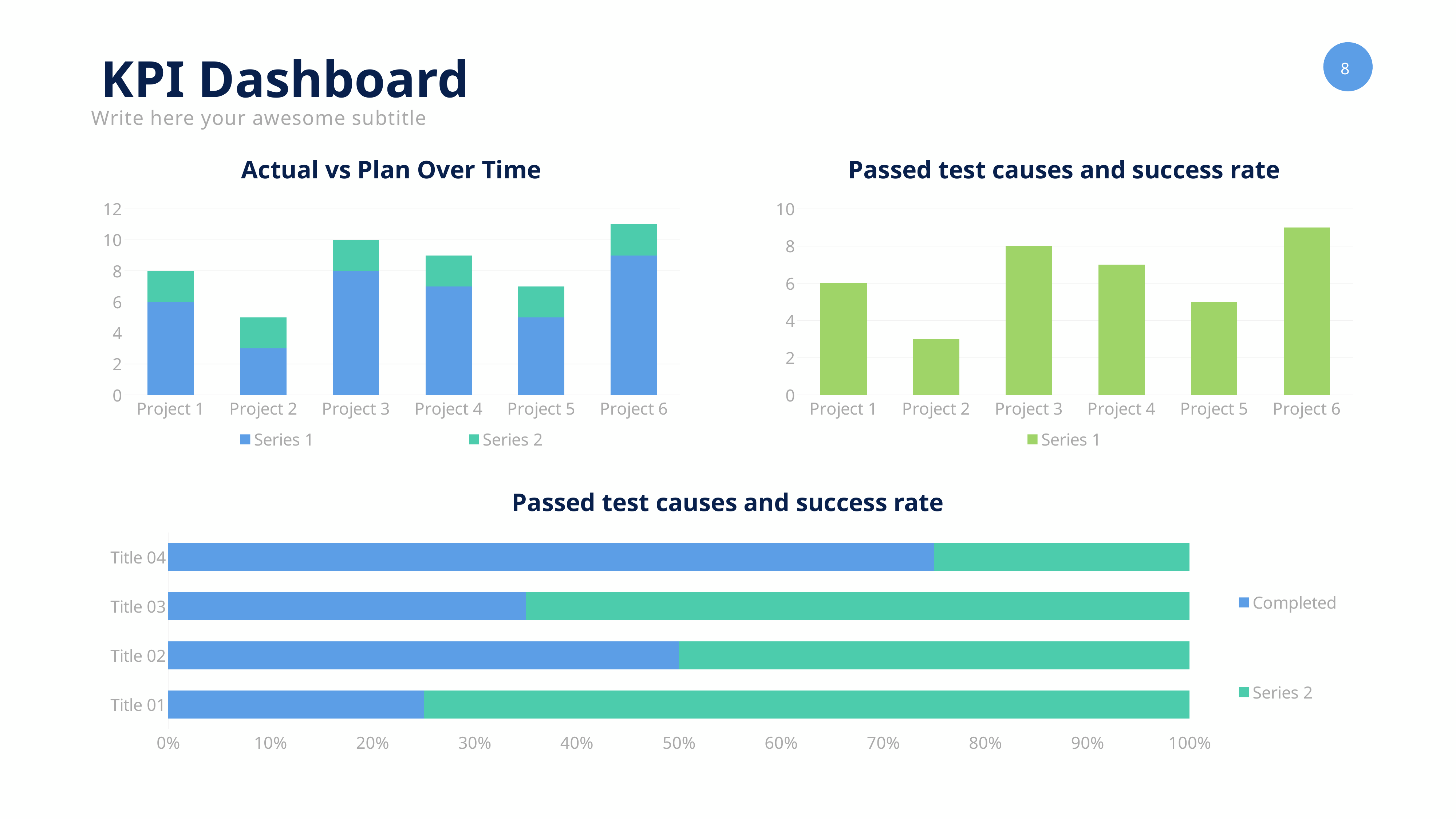
In the bottom 'Passed test causes and success rate' chart, what is the Completed value for Title 02? 50% In the top-right 'Passed test causes and success rate' chart, which project has the highest value? Project 6 In the 'Actual vs Plan Over Time' chart, what is the Series 1 value for Project 1? 6 In the 'Actual vs Plan Over Time' chart, what is the total height of the stacked bar for Project 3? 10 In the top-right 'Passed test causes and success rate' chart, what is the value for Project 1? 6 In the 'Actual vs Plan Over Time' chart, what is the Series 1 value for Project 3? 8 In the 'Actual vs Plan Over Time' chart, is the Series 1 value for Project 2 greater or less than 4? less In the top-right 'Passed test causes and success rate' chart, how many projects are shown on the x axis? 6 In the top-right 'Passed test causes and success rate' chart, which project has the lowest value? Project 2 In the 'Actual vs Plan Over Time' chart, which project has the tallest stacked bar? Project 6 In the 'Actual vs Plan Over Time' chart, how many series does the legend list? 2 In the bottom 'Passed test causes and success rate' chart, is the Completed value for Title 04 greater or less than 70%? greater